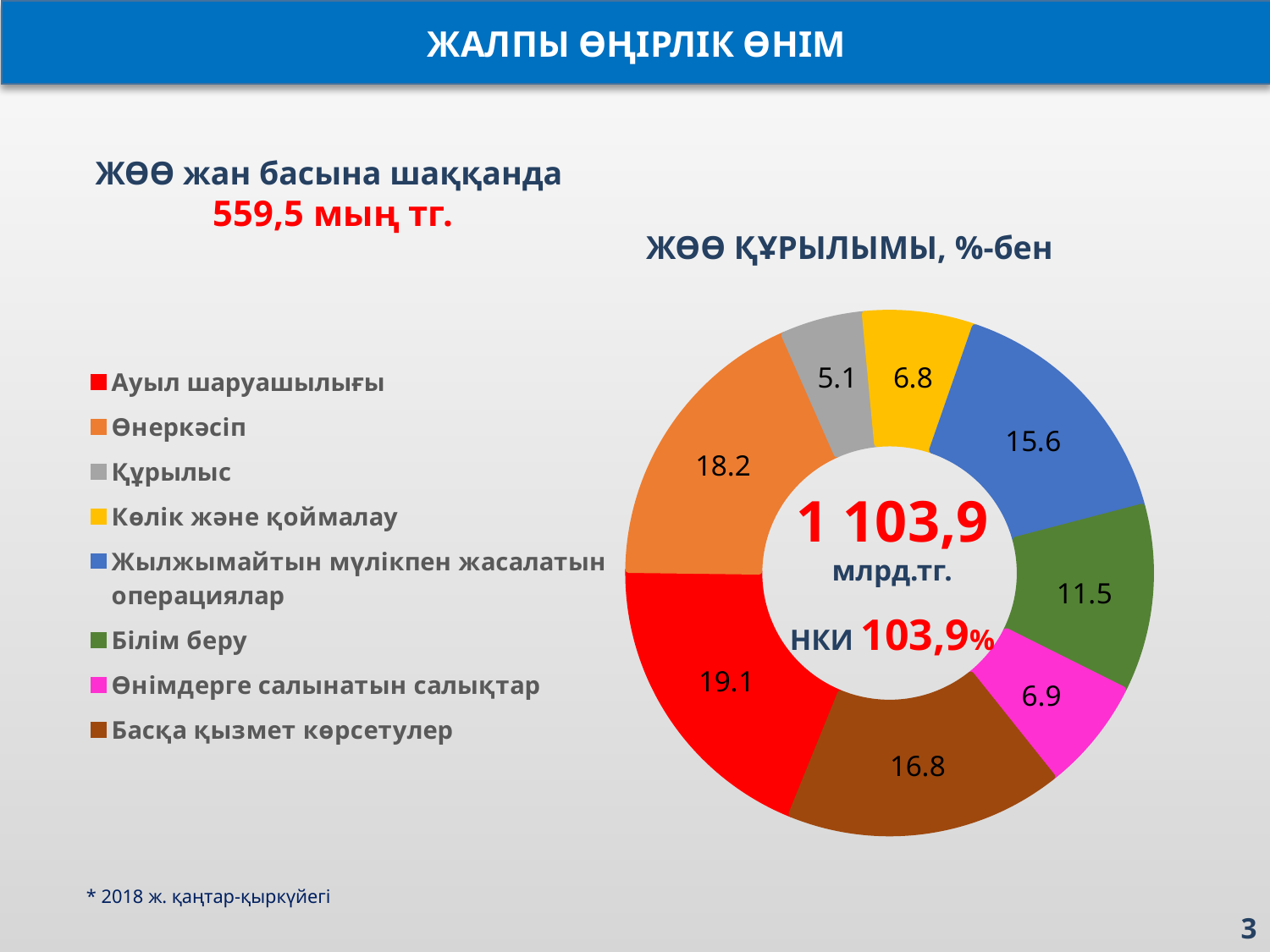
What is the value for Құрылыс in the ЖӨӨ ҚҰРЫЛЫМЫ chart? 5.1 What is the value for Ауыл шаруашылығы in the ЖӨӨ ҚҰРЫЛЫМЫ chart? 19.1 What colour represents Өнімдерге салынатын салықтар in the chart? Magenta (pink) What is the difference between the values for Ауыл шаруашылығы and Өнеркәсіп? 0.9 What kind of chart is shown on the slide? Doughnut (pie) chart Which category has the largest share in the ЖӨӨ ҚҰРЫЛЫМЫ chart? Ауыл шаруашылығы Which is larger: the value for Жылжымайтын мүлікпен жасалатын операциялар or the value for Басқа қызмет көрсетулер? Басқа қызмет көрсетулер How many categories does the ЖӨӨ ҚҰРЫЛЫМЫ chart show? 8 Which category has the smallest share in the ЖӨӨ ҚҰРЫЛЫМЫ chart? Құрылыс What total value is printed in the centre of the doughnut chart? 1 103,9 млрд.тг. What is the value for Білім беру in the ЖӨӨ ҚҰРЫЛЫМЫ chart? 11.5 What is the value for Өнеркәсіп in the ЖӨӨ ҚҰРЫЛЫМЫ chart? 18.2